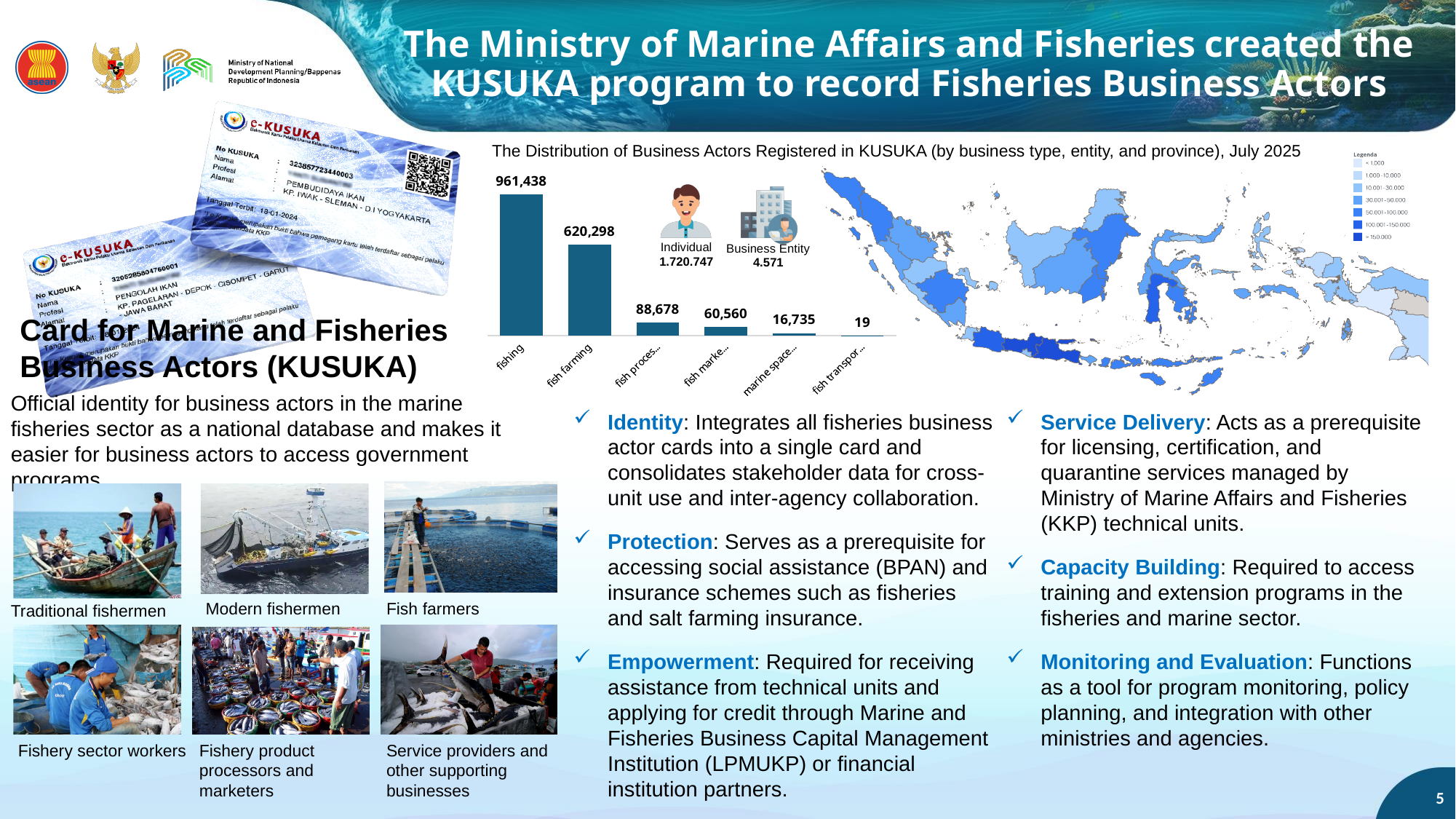
In the bar chart, what is the difference between the number of registered actors in fishing and in fish farming? 341,140 What type of chart is used to show the distribution of business actors registered in KUSUKA by business type? bar chart In the bar chart of business actors registered in KUSUKA, what is the value for fish farming? 620,298 Which business type has the highest number of registered business actors in the bar chart? fishing According to the infographic next to the bar chart, how many registered business actors are individuals and how many are business entities? Individual 1.720.747; Business Entity 4.571 In the bar chart of business actors registered in KUSUKA, what is the value for the 'fish transpor...' category? 19 Do the bar values rise or fall from left to right across the business type categories? fall In the bar chart of business actors registered in KUSUKA, what is the value for the 'marine space...' category? 16,735 In the bar chart of business actors registered in KUSUKA, what is the value for fishing? 961,438 In the bar chart, which is larger: the value for 'fish proces...' or the value for 'fish marke...'? fish proces... Which business type has the lowest number of registered business actors in the bar chart? fish transpor... How many business type categories are shown in the bar chart? 6